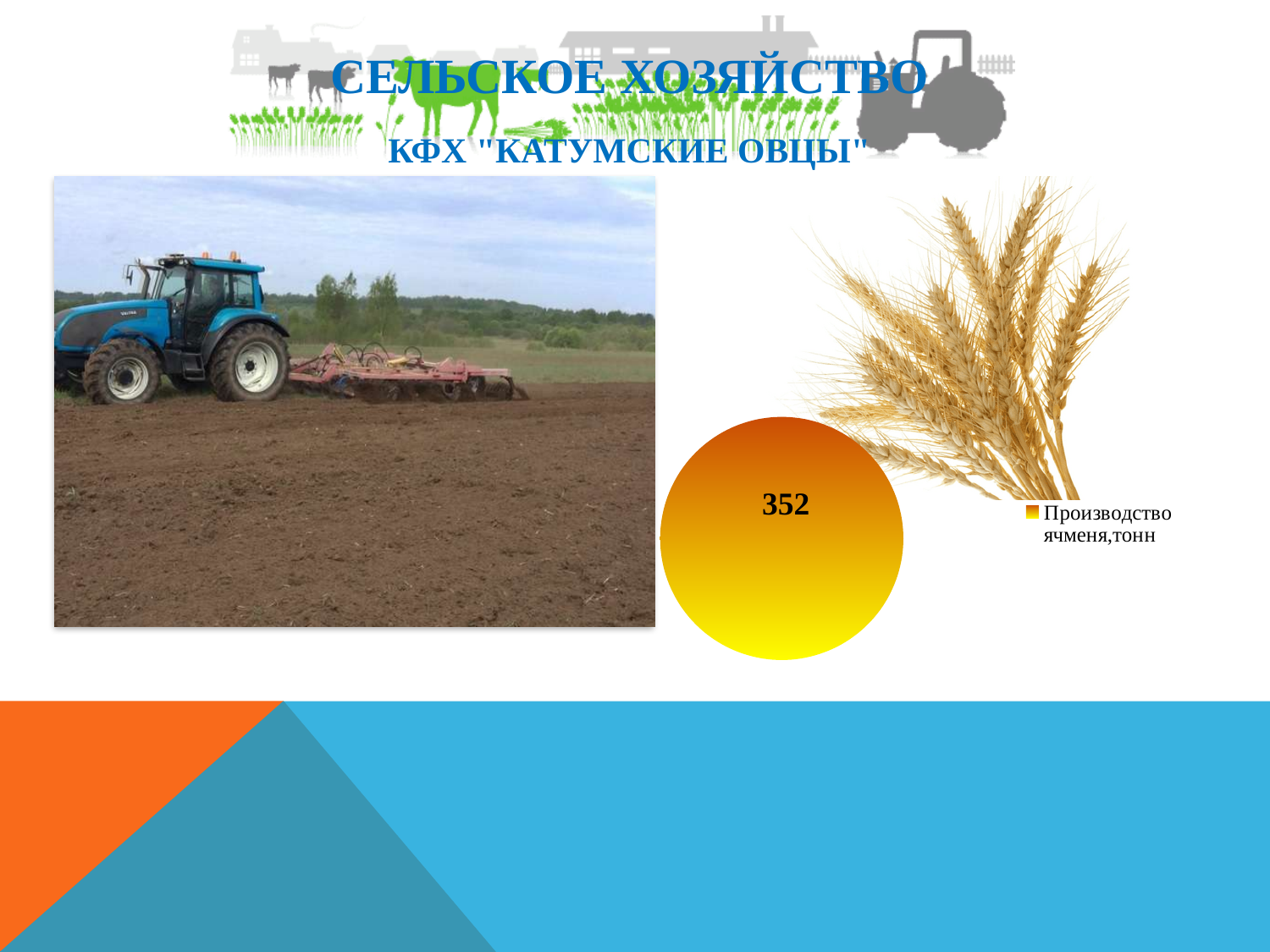
What is the value for Производство ячменя,тонн on the pie chart? 352 What kind of chart is shown on the slide? pie chart What value is shown on the pie chart? 352 How many slices does the pie chart have? 1 How many entries does the legend of the pie chart list? 1 What share of the pie does the Производство ячменя,тонн slice take? 100% What is the legend entry of the pie chart? Производство ячменя,тонн What colour is the slice of the pie chart? yellow-orange